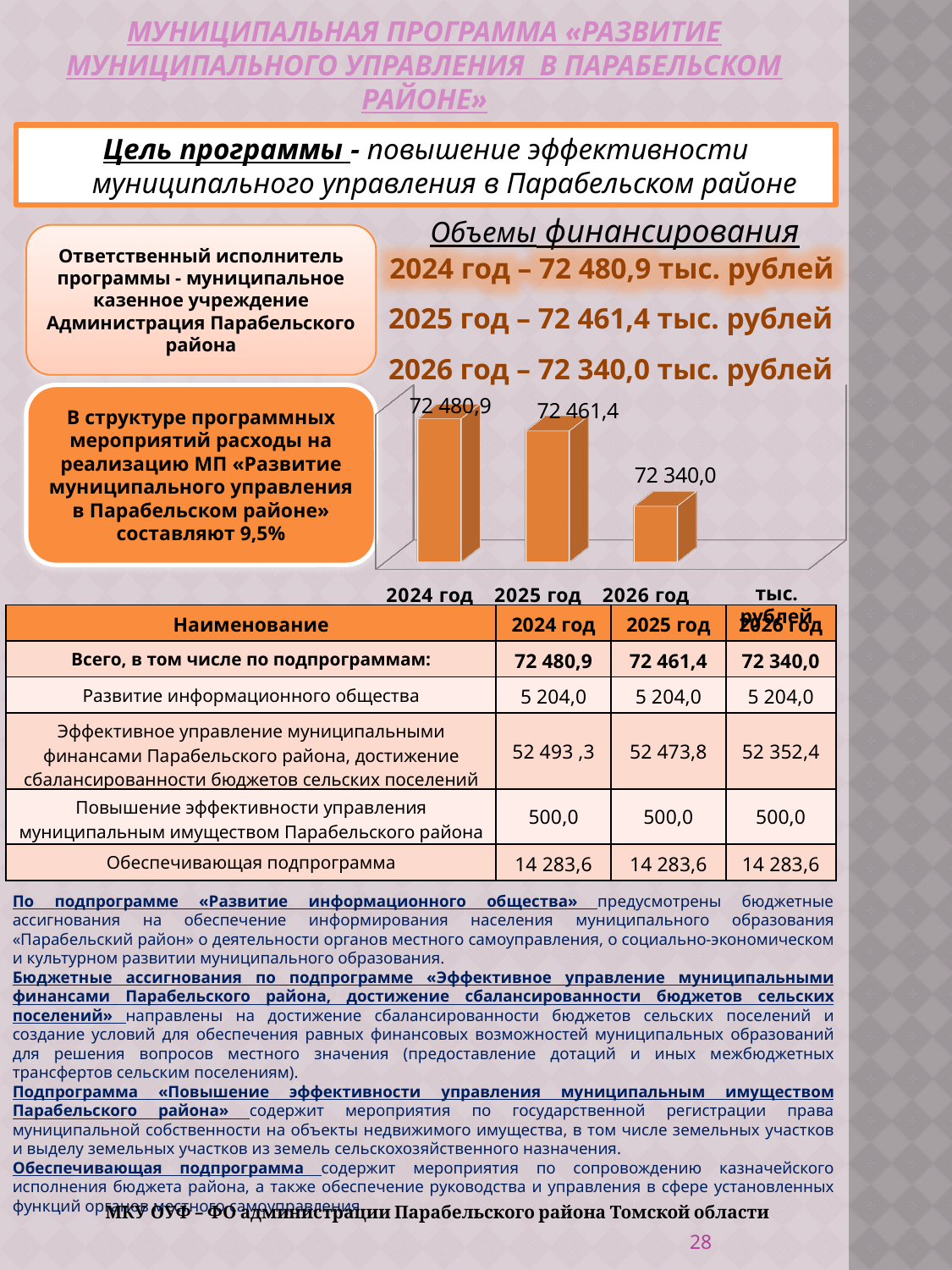
What is the value shown for 2026 год in the chart? 72 340,0 What is the value shown for 2024 год in the chart? 72 480,9 What is the value shown for 2025 год in the chart? 72 461,4 Which year has the lowest value in the chart? 2026 год Which year has the highest value in the chart? 2024 год Do the values rise or fall from 2024 год to 2026 год? fall What is the difference between the values for 2024 год and 2026 год? 140,9 What is the difference between the values for 2024 год and 2025 год? 19,5 What kind of chart is shown on the slide? bar chart Which is larger, the value for 2024 год or the value for 2026 год? 2024 год How many years (categories) are plotted in the chart? 3 What is the difference between the values for 2025 год and 2026 год? 121,4